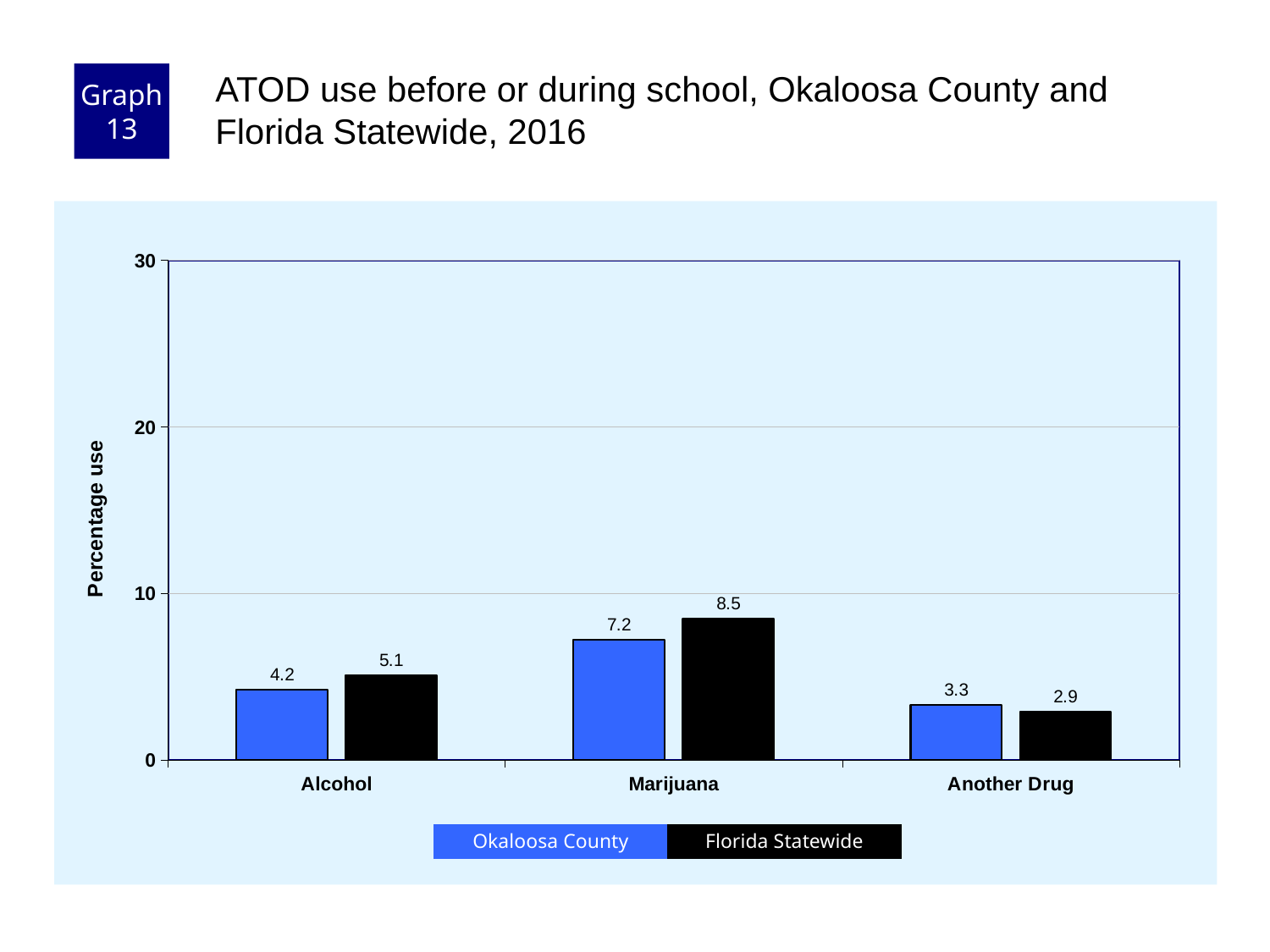
How many categories are shown on the x axis? 3 What is the difference between the Okaloosa County and Florida Statewide values for Another Drug? 0.4 What is the Florida Statewide value for Marijuana? 8.5 Is the Florida Statewide value for Marijuana greater or less than 10? less What is the Okaloosa County value for Alcohol? 4.2 What is the difference between the Florida Statewide and Okaloosa County values for Marijuana? 1.3 How many series does the legend list? 2 Which category has the lowest Florida Statewide value? Another Drug For Alcohol, which is larger: Okaloosa County or Florida Statewide? Florida Statewide What is the Florida Statewide value for Another Drug? 2.9 Which category has the highest Okaloosa County value? Marijuana What kind of chart is shown on the slide? bar chart